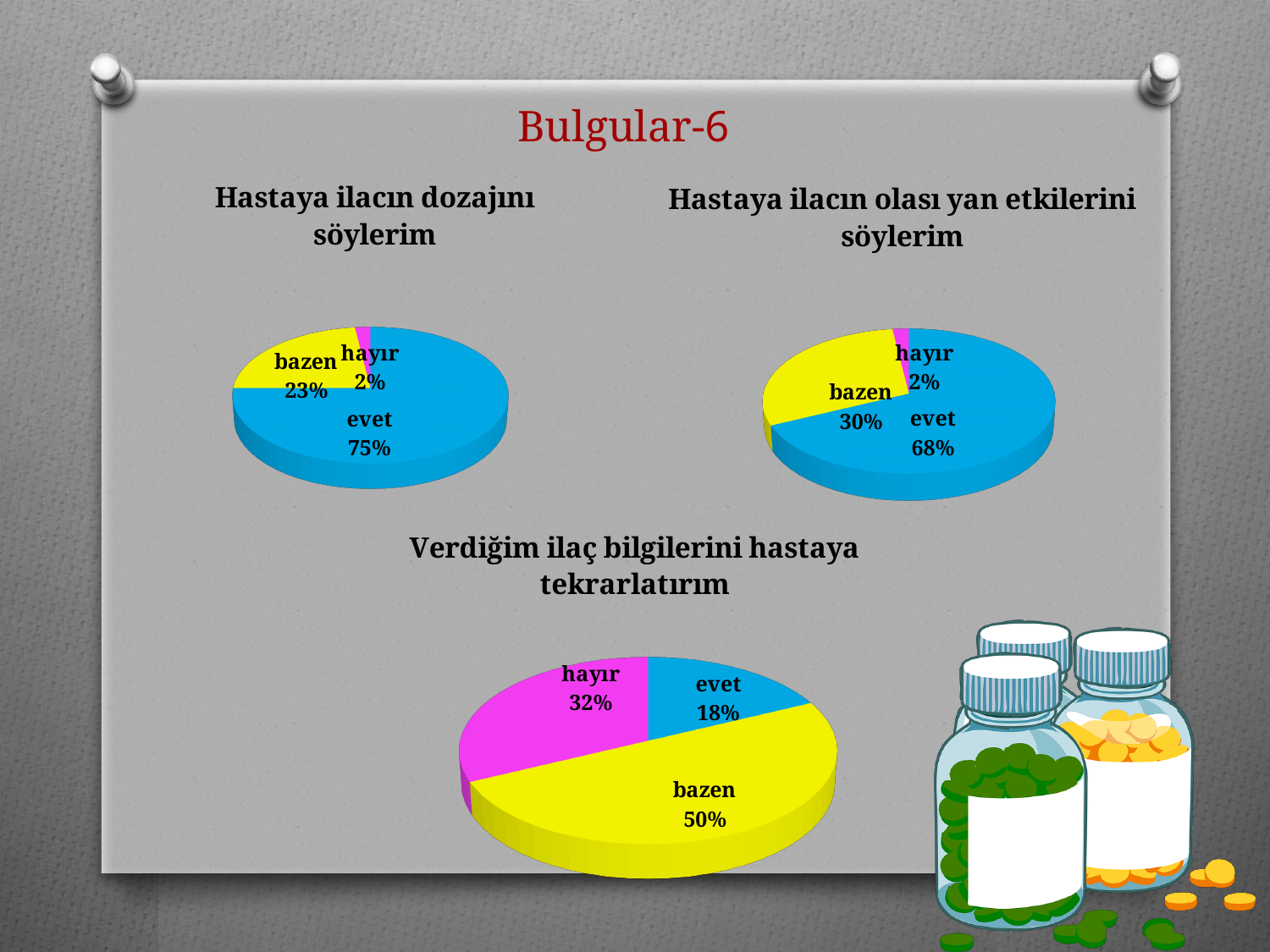
In the chart titled 'Verdiğim ilaç bilgilerini hastaya tekrarlatırım', what percentage is shown for 'hayır'? 32% In the chart titled 'Hastaya ilacın dozajını söylerim', which category has the smallest share? hayır How many slices does the chart titled 'Hastaya ilacın dozajını söylerim' have? 3 In the chart titled 'Hastaya ilacın olası yan etkilerini söylerim', what percentage is shown for 'evet'? 68% In the chart titled 'Hastaya ilacın dozajını söylerim', what percentage is shown for 'evet'? 75% In the chart titled 'Hastaya ilacın olası yan etkilerini söylerim', what percentage is shown for 'bazen'? 30% In the chart titled 'Hastaya ilacın dozajını söylerim', what percentage is shown for 'bazen'? 23% In the chart titled 'Verdiğim ilaç bilgilerini hastaya tekrarlatırım', which category has the smallest share? evet In the chart titled 'Verdiğim ilaç bilgilerini hastaya tekrarlatırım', which category has the largest share? bazen What type of chart is used for 'Verdiğim ilaç bilgilerini hastaya tekrarlatırım'? pie chart In the chart titled 'Hastaya ilacın olası yan etkilerini söylerim', what is the difference in percentage points between 'evet' and 'bazen'? 38 In the chart titled 'Verdiğim ilaç bilgilerini hastaya tekrarlatırım', which is larger, 'hayır' or 'evet'? hayır